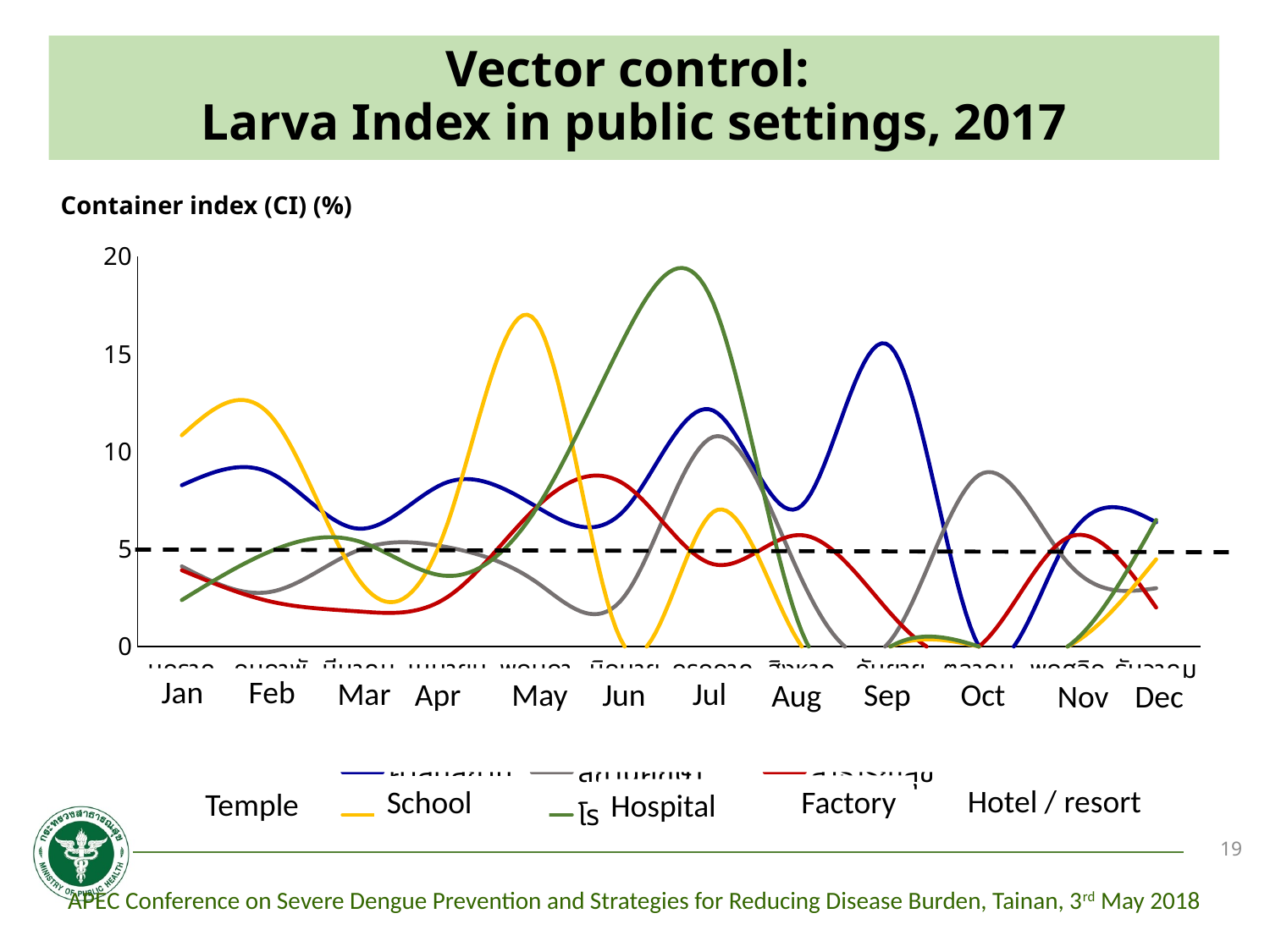
How many series does the chart's legend list? 5 Is the value of the blue line in Sep greater or less than 10? greater What kind of chart is shown on the slide? Line chart How many months are shown along the x axis of the chart? 12 What is the title of the slide containing the chart? Vector control: Larva Index in public settings, 2017 Which line is higher in Jul, the green line or the blue line? Green line In which month does the yellow line reach its highest value? May Is the value of the red line in Mar greater or less than 5? less Is the peak value of the green line in Jul greater or less than 15? greater In which month does the green line reach its highest value? Jul What quantity is plotted on the y axis of the chart? Container index (CI) (%)